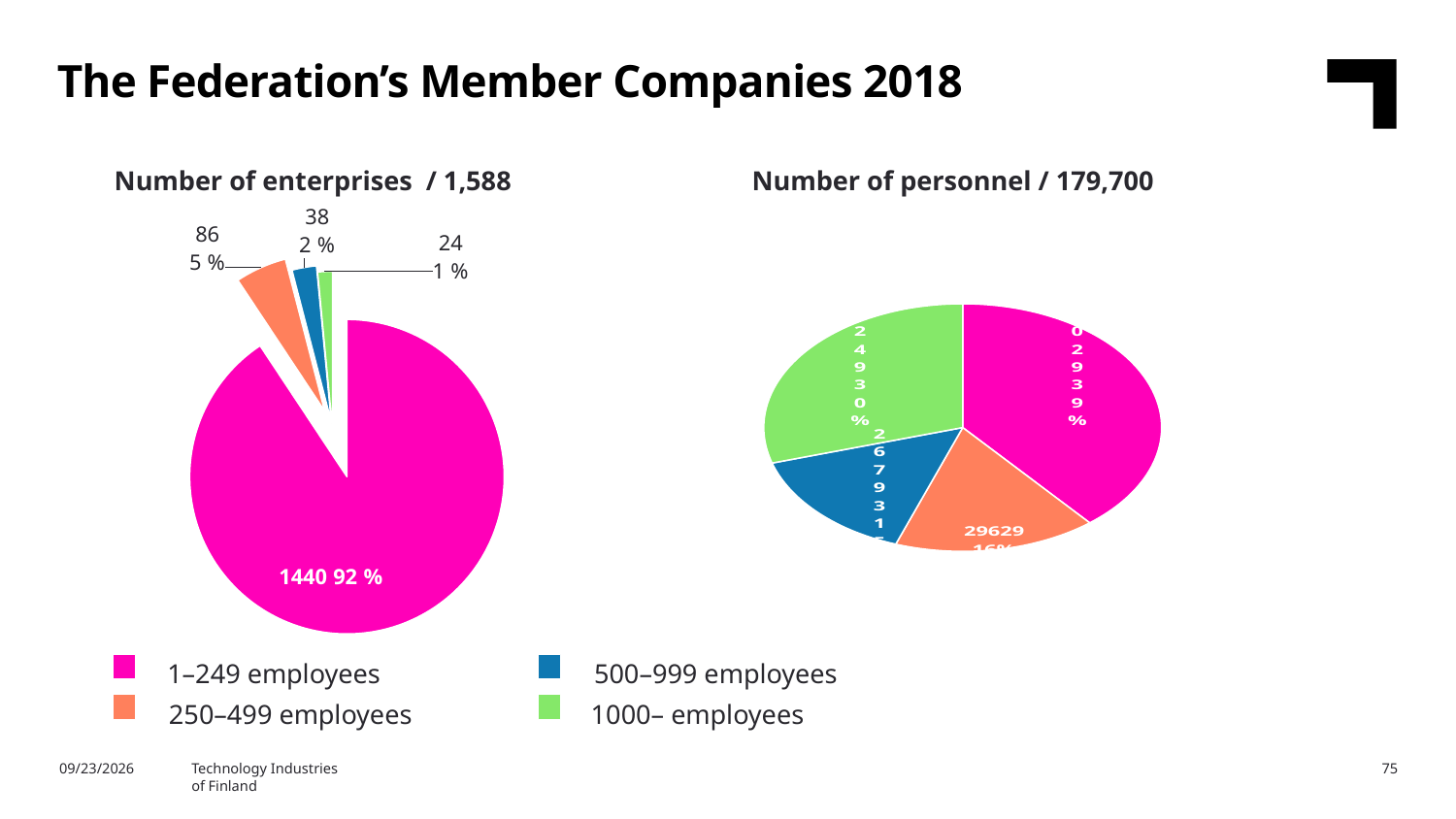
In the 'Number of enterprises / 1,588' chart, which has more enterprises: 250–499 employees or 500–999 employees? 250–499 employees In the 'Number of personnel / 179,700' chart, which employee-size category accounts for the largest share of personnel? 1–249 employees In the 'Number of enterprises / 1,588' chart, which employee-size category has the fewest enterprises? 1000– employees What kind of chart is the 'Number of enterprises / 1,588' chart? pie chart In the 'Number of enterprises / 1,588' chart, how many enterprises have 250–499 employees? 86 In the 'Number of enterprises / 1,588' chart, how many enterprises have 1000 or more employees? 24 In the 'Number of enterprises / 1,588' chart, how many enterprises have 1–249 employees? 1440 How many employee-size categories does the legend list? 4 In the 'Number of enterprises / 1,588' chart, what share of enterprises have 1–249 employees? 92 % In the 'Number of enterprises / 1,588' chart, what is the difference between the number of enterprises with 1–249 employees and those with 250–499 employees? 1354 In the 'Number of enterprises / 1,588' chart, which employee-size category has the most enterprises? 1–249 employees In the 'Number of enterprises / 1,588' chart, what share of enterprises have 500–999 employees? 2 %